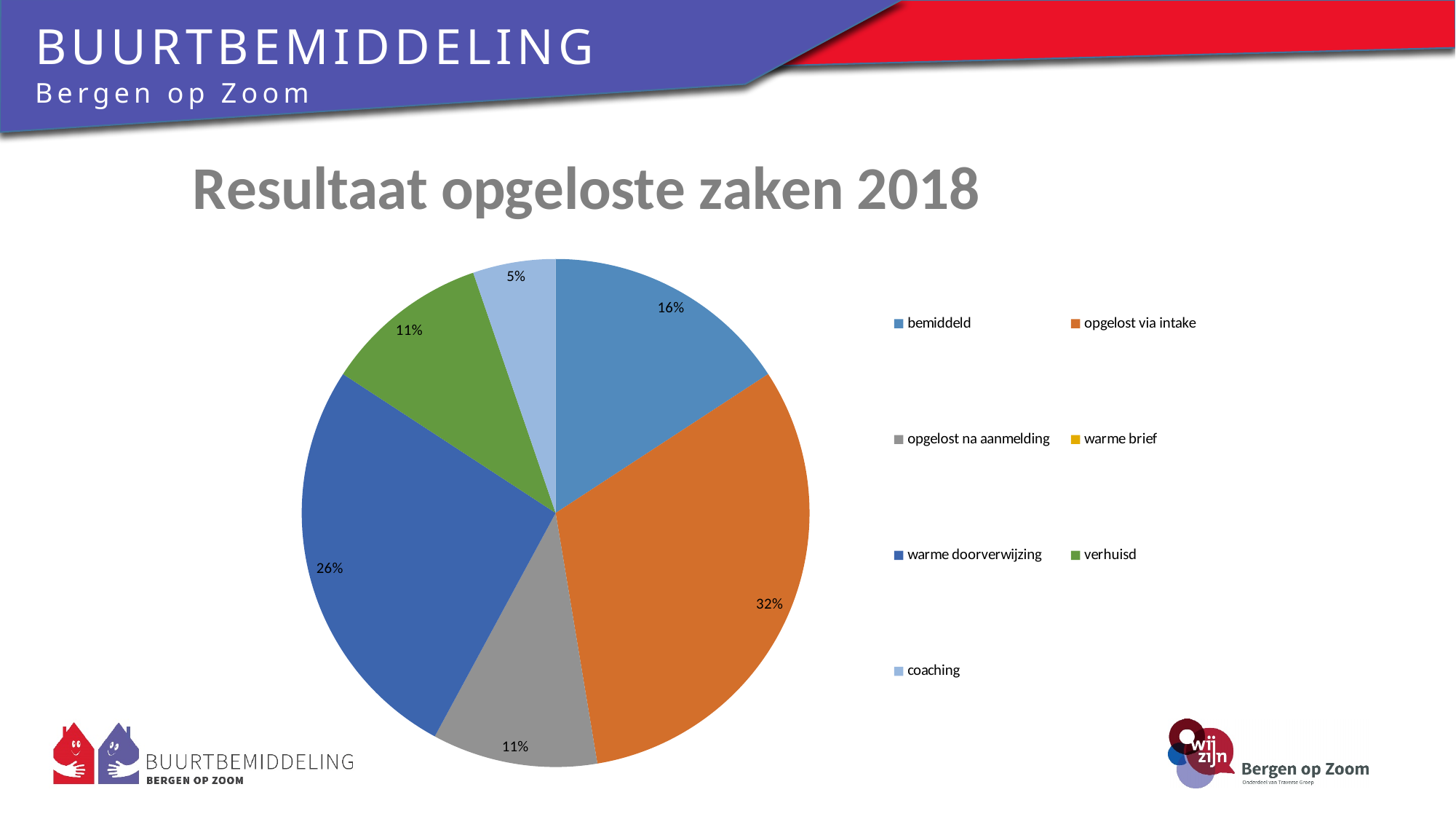
Which category has the smallest visible slice of the pie? coaching What kind of chart is shown on the slide? pie chart Which is larger, the slice for 'bemiddeld' or the slice for 'warme doorverwijzing'? warme doorverwijzing What is the title of the chart? Resultaat opgeloste zaken 2018 What share of the pie does 'coaching' represent? 5% How many entries does the legend list? 7 What share of the pie does 'bemiddeld' represent? 16% What share of the pie does 'verhuisd' represent? 11% What is the difference in percentage points between 'opgelost via intake' and 'warme doorverwijzing'? 6 Which category has the largest slice of the pie? opgelost via intake